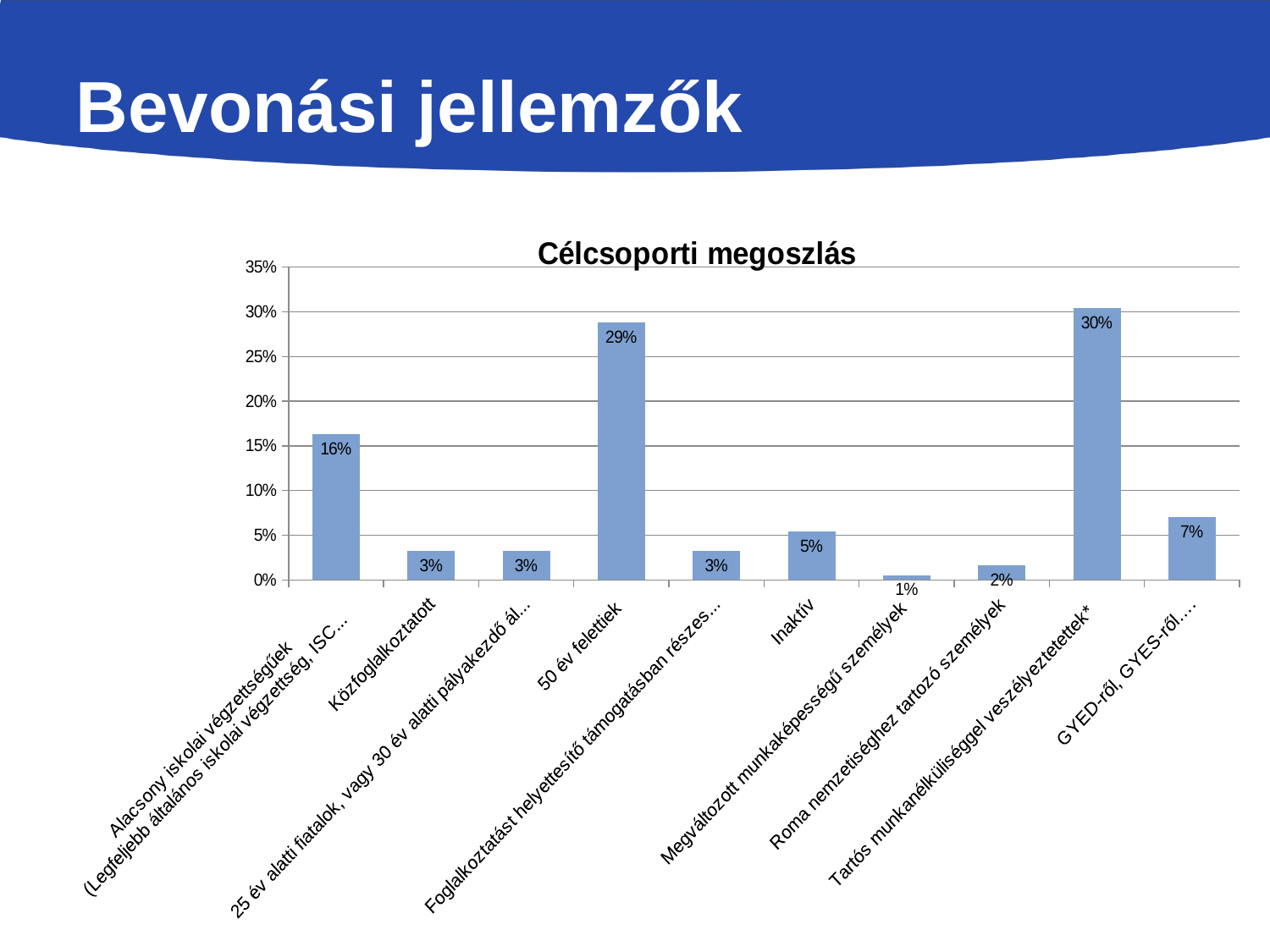
What is the difference between the value for Tartós munkanélküliséggel veszélyeztetettek* and the value for Inaktív? 25% How many categories are shown on the x axis? 10 What is the value for Közfoglalkoztatott? 3% What type of chart is shown on the slide? bar chart What is the value for Inaktív? 5% What is the title of the chart? Célcsoporti megoszlás What is the value for Roma nemzetiséghez tartozó személyek? 2% Which category has the highest value? Tartós munkanélküliséggel veszélyeztetettek* Which is larger, the value for Alacsony iskolai végzettségűek or the value for Inaktív? Alacsony iskolai végzettségűek Is the value for Alacsony iskolai végzettségűek greater or less than 15%? greater Which category has the lowest value? Megváltozott munkaképességű személyek What is the value for 50 év felettiek? 29%